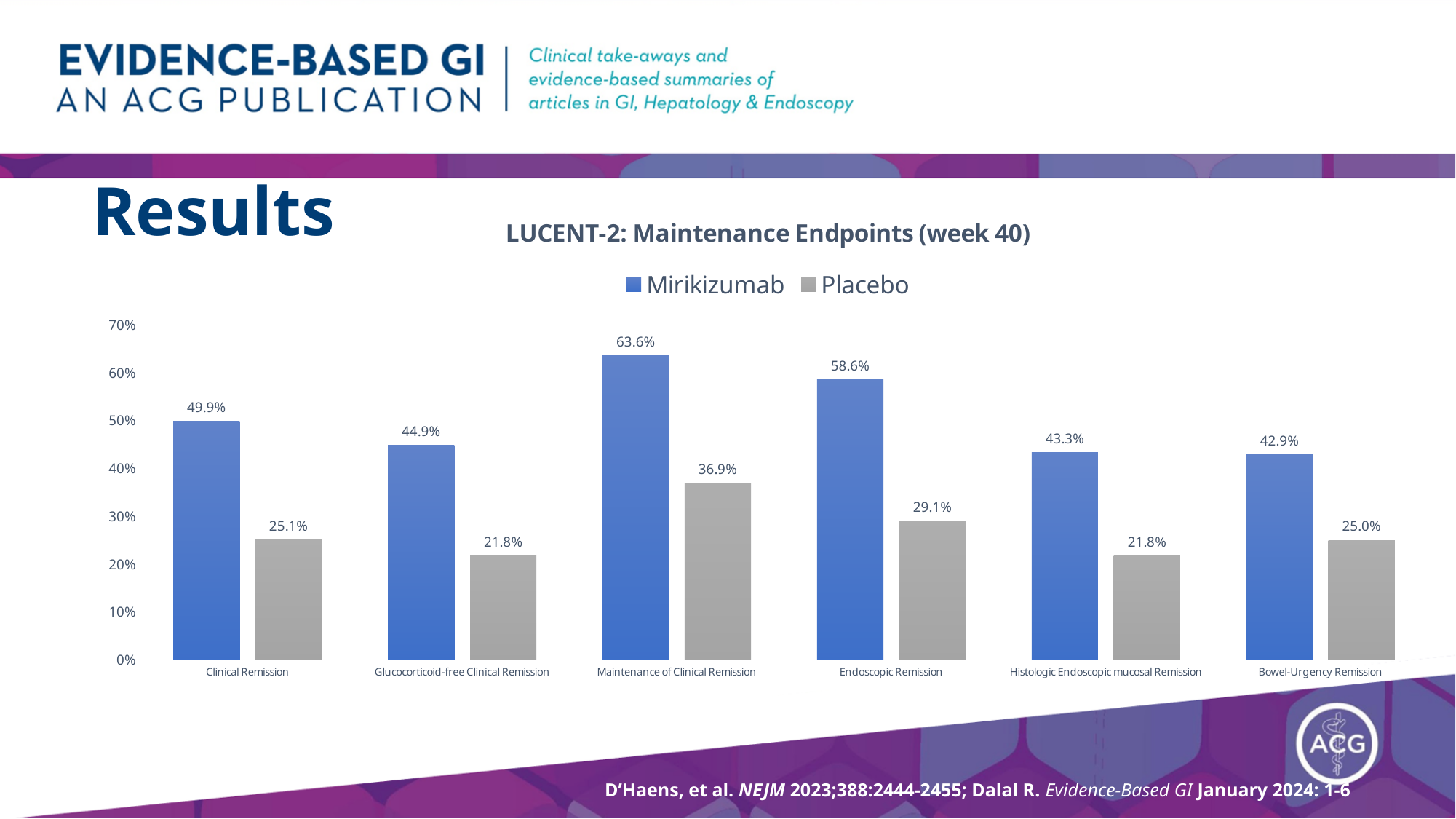
Which colour represents Placebo in the chart? Grey Which is larger: the Placebo value for Maintenance of Clinical Remission or the Placebo value for Clinical Remission? Maintenance of Clinical Remission How many categories are shown on the x axis? 6 What is the Mirikizumab value for Bowel-Urgency Remission? 42.9% Which category has the lowest Placebo value? Glucocorticoid-free Clinical Remission and Histologic Endoscopic mucosal Remission (both 21.8%) What is the title of the chart? LUCENT-2: Maintenance Endpoints (week 40) What is the Mirikizumab value for Clinical Remission? 49.9% What kind of chart is shown on the slide? Bar chart How many series does the legend list? 2 Which category has the highest Mirikizumab value? Maintenance of Clinical Remission What is the difference between the Mirikizumab and Placebo values for Endoscopic Remission? 29.5% What is the Placebo value for Endoscopic Remission? 29.1%